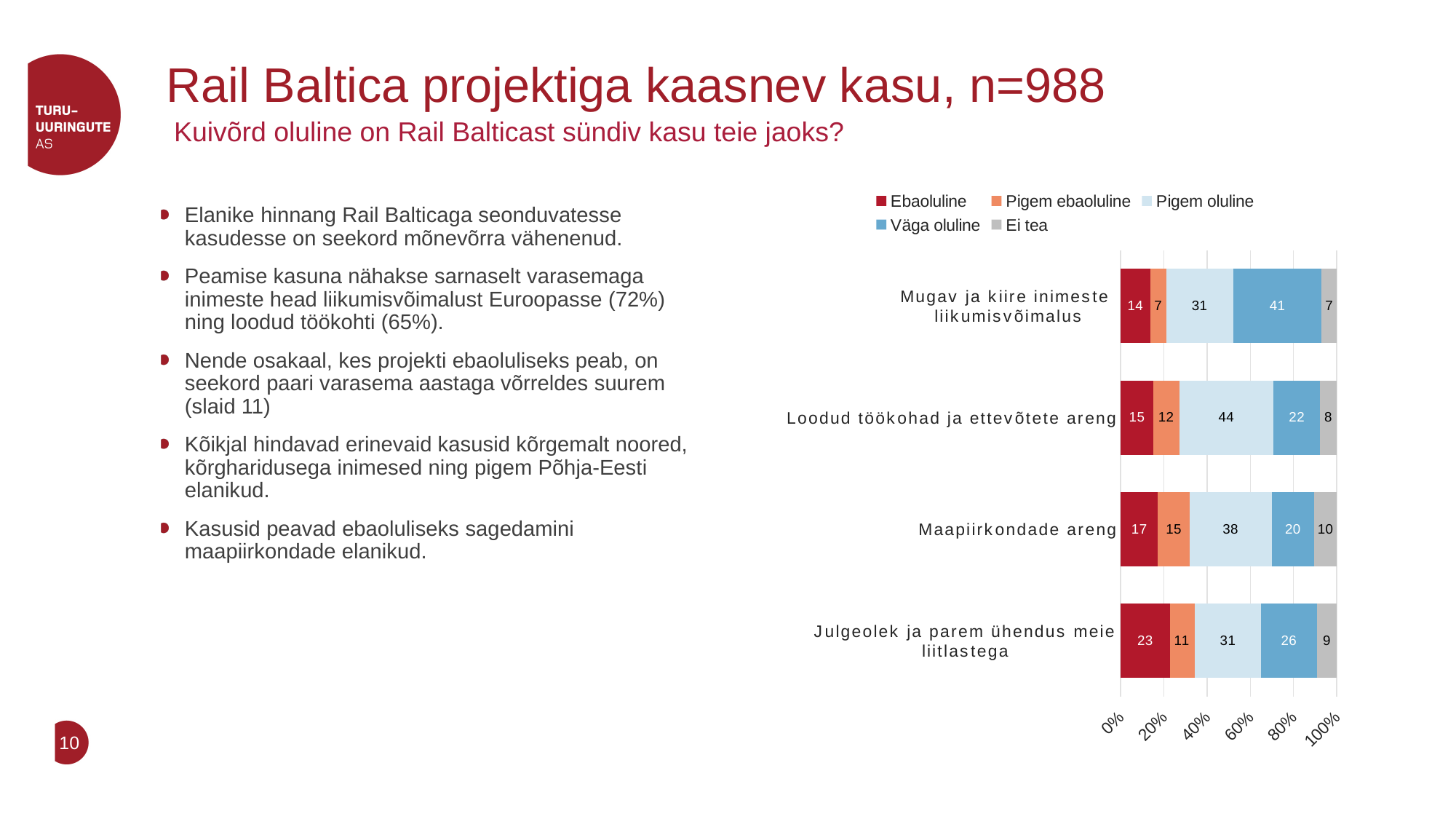
What is the difference between the "Väga oluline" values for "Mugav ja kiire inimeste liikumisvõimalus" and "Julgeolek ja parem ühendus meie liitlastega"? 15 What is the value of "Pigem oluline" for "Loodud töökohad ja ettevõtete areng"? 44 Which category has the lowest "Väga oluline" value? Maapiirkondade areng Which is larger: the "Pigem ebaoluline" value for "Maapiirkondade areng" or for "Loodud töökohad ja ettevõtete areng"? Maapiirkondade areng Which legend entry is shown in dark red? Ebaoluline Which category has the highest "Ebaoluline" value? Julgeolek ja parem ühendus meie liitlastega What is the total of the stacked bar for "Julgeolek ja parem ühendus meie liitlastega"? 100 How many series does the chart legend list? 5 What kind of chart is shown on the slide? stacked bar chart How many categories are plotted in the chart? 4 What is the value of "Väga oluline" for "Mugav ja kiire inimeste liikumisvõimalus"? 41 What is the value of "Ei tea" for "Maapiirkondade areng"? 10